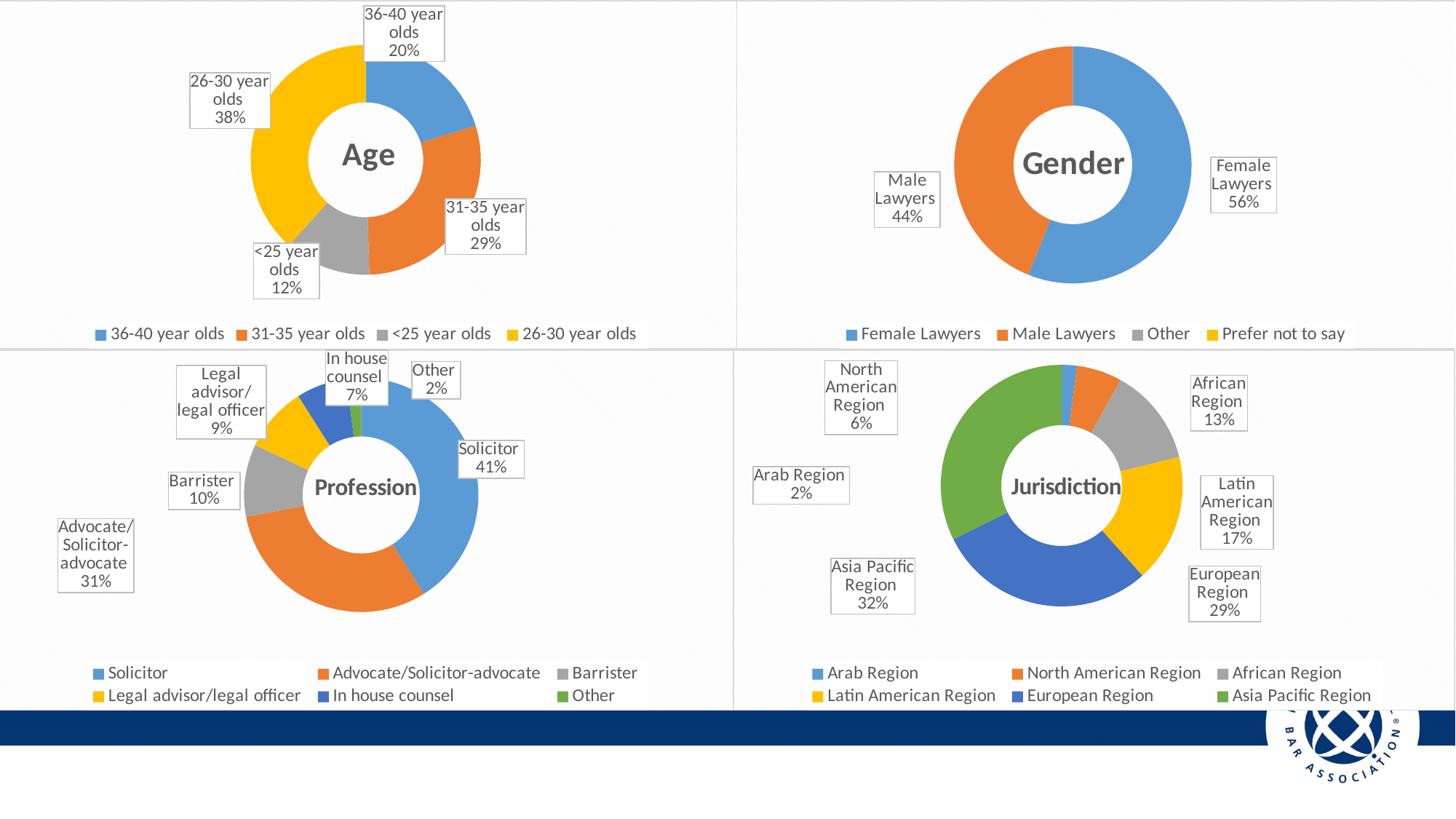
In the Jurisdiction chart, which region has the largest share? Asia Pacific Region What type of chart is the Jurisdiction chart? Donut (pie) chart In the Gender chart, what share of respondents are Male Lawyers? 44% In the Age chart, what is the difference between the shares of 31-35 year olds and 36-40 year olds? 9% In the Profession chart, what share of respondents are Barristers? 10% In the Profession chart, which profession has the largest share? Solicitor In the Jurisdiction chart, what share of respondents are from the European Region? 29% In the Age chart, what share of respondents are 26-30 year olds? 38% In the Profession chart, which is larger: Legal advisor/legal officer or In house counsel? Legal advisor/legal officer In the Jurisdiction chart, how many regions are shown? 6 In the Gender chart, how many entries does the legend list? 4 In the Age chart, which age group has the smallest share? <25 year olds